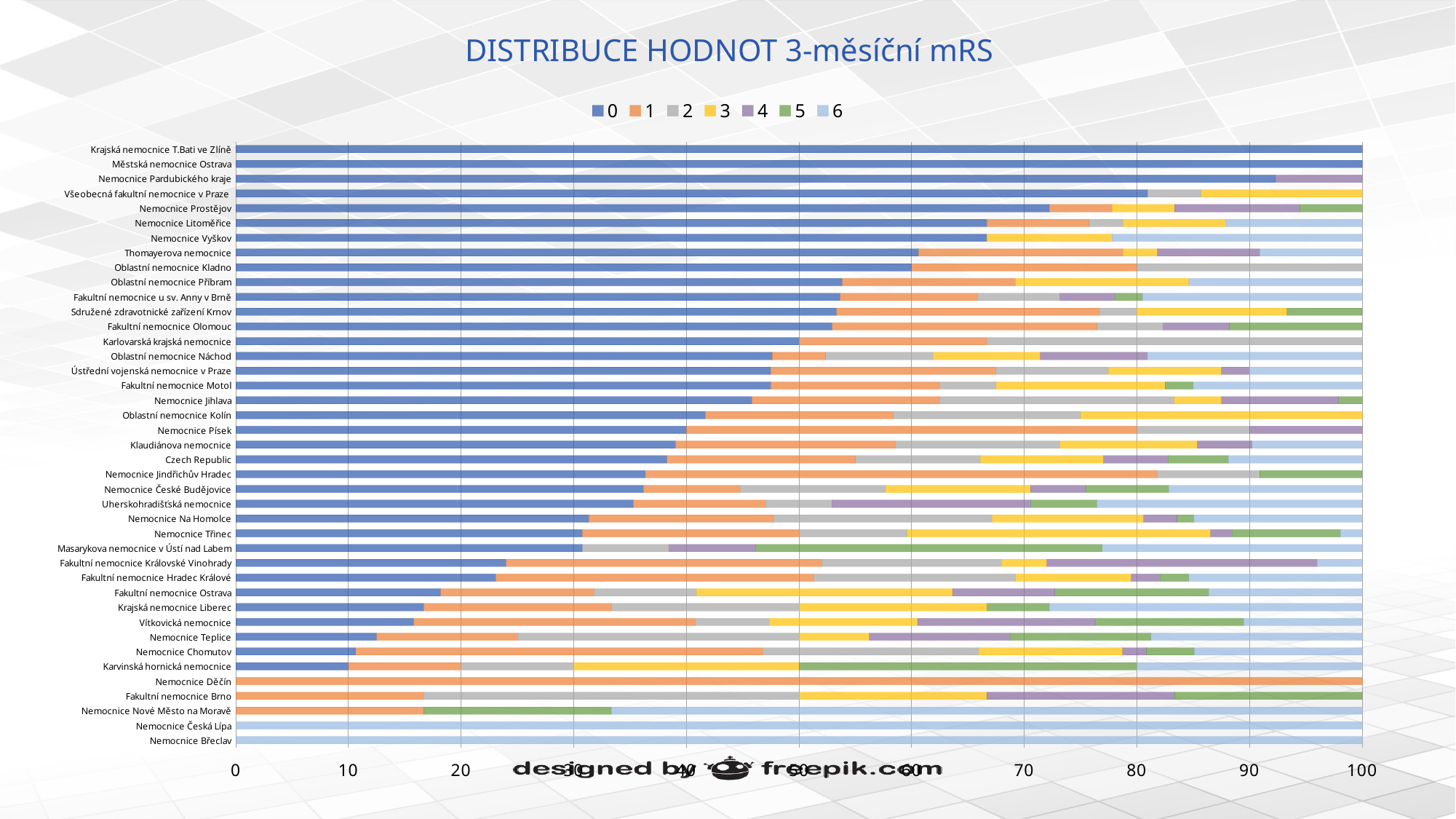
How many hospital categories are plotted on the chart? 41 What is the title of the chart? DISTRIBUCE HODNOT 3-měsíční mRS Which legend entry is shown in yellow? 3 Is the value of series 0 for Nemocnice Prostějov greater or less than 70? greater Is the value of series 0 for Karvinská hornická nemocnice greater or less than 20? less What kind of chart is shown on the slide? Stacked bar chart What value does the series 1 segment reach for Nemocnice Děčín? 100 What is the total of the stacked bar for Czech Republic? 100 Is the value of series 0 for Czech Republic greater or less than 40? less What value does the series 6 segment reach for Nemocnice Břeclav? 100 How many series does the legend list? 7 Which has a larger series 0 value: Nemocnice Prostějov or Nemocnice Teplice? Nemocnice Prostějov